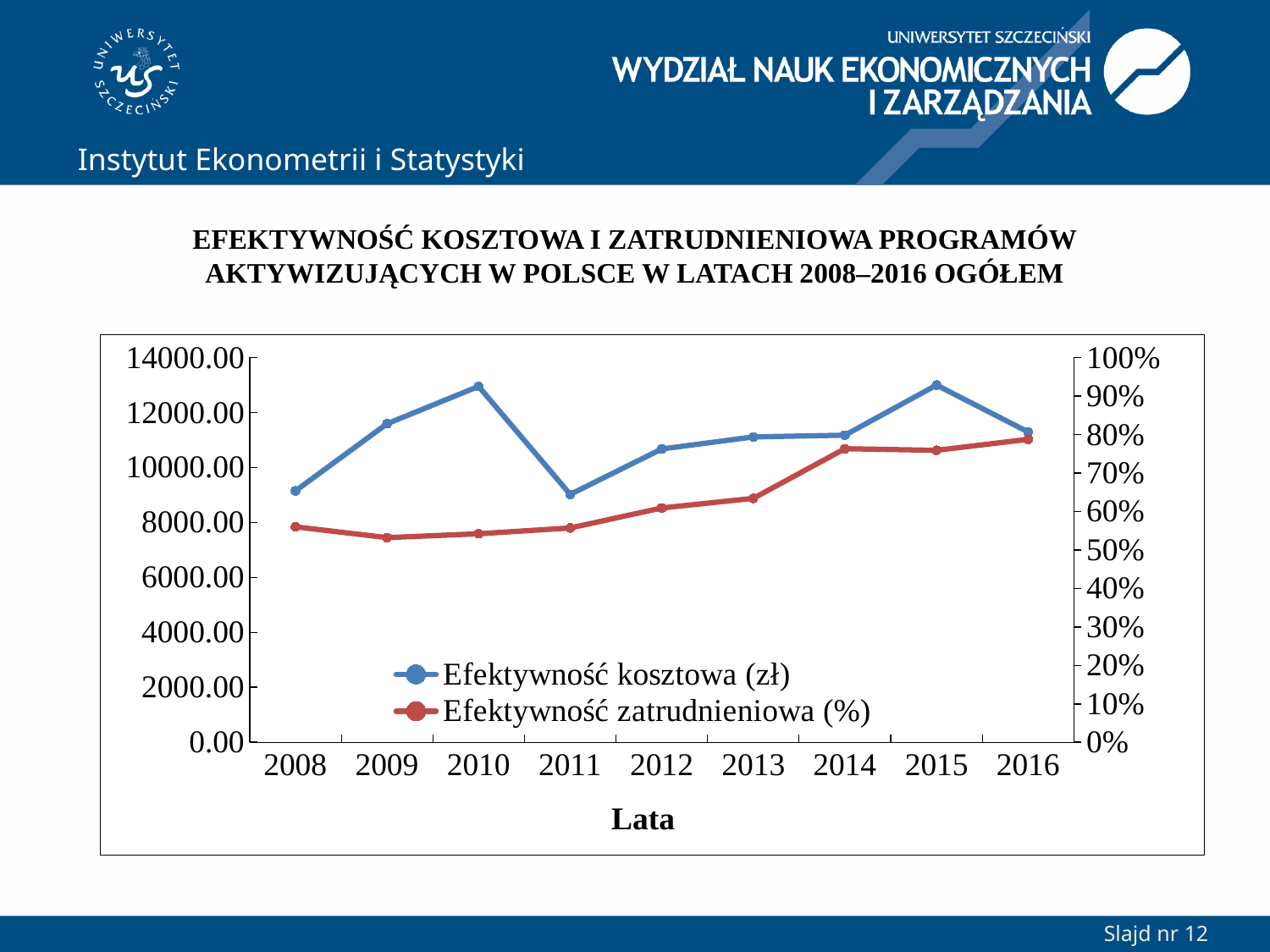
Is the value of Efektywność kosztowa (zł) for 2009 greater or less than 10000.00? greater Which year has the larger value of Efektywność kosztowa (zł), 2010 or 2011? 2010 How many series does the legend list? 2 Which year has the larger value of Efektywność zatrudnieniowa (%), 2008 or 2016? 2016 Is the value of Efektywność zatrudnieniowa (%) for 2008 greater or less than 60%? less How many years are plotted along the x axis? 9 Is the value of Efektywność kosztowa (zł) for 2011 greater or less than 10000.00? less What is the label of the x axis? Lata Does Efektywność zatrudnieniowa (%) generally rise or fall from 2009 to 2016? rise What kind of chart is shown on the slide? line chart